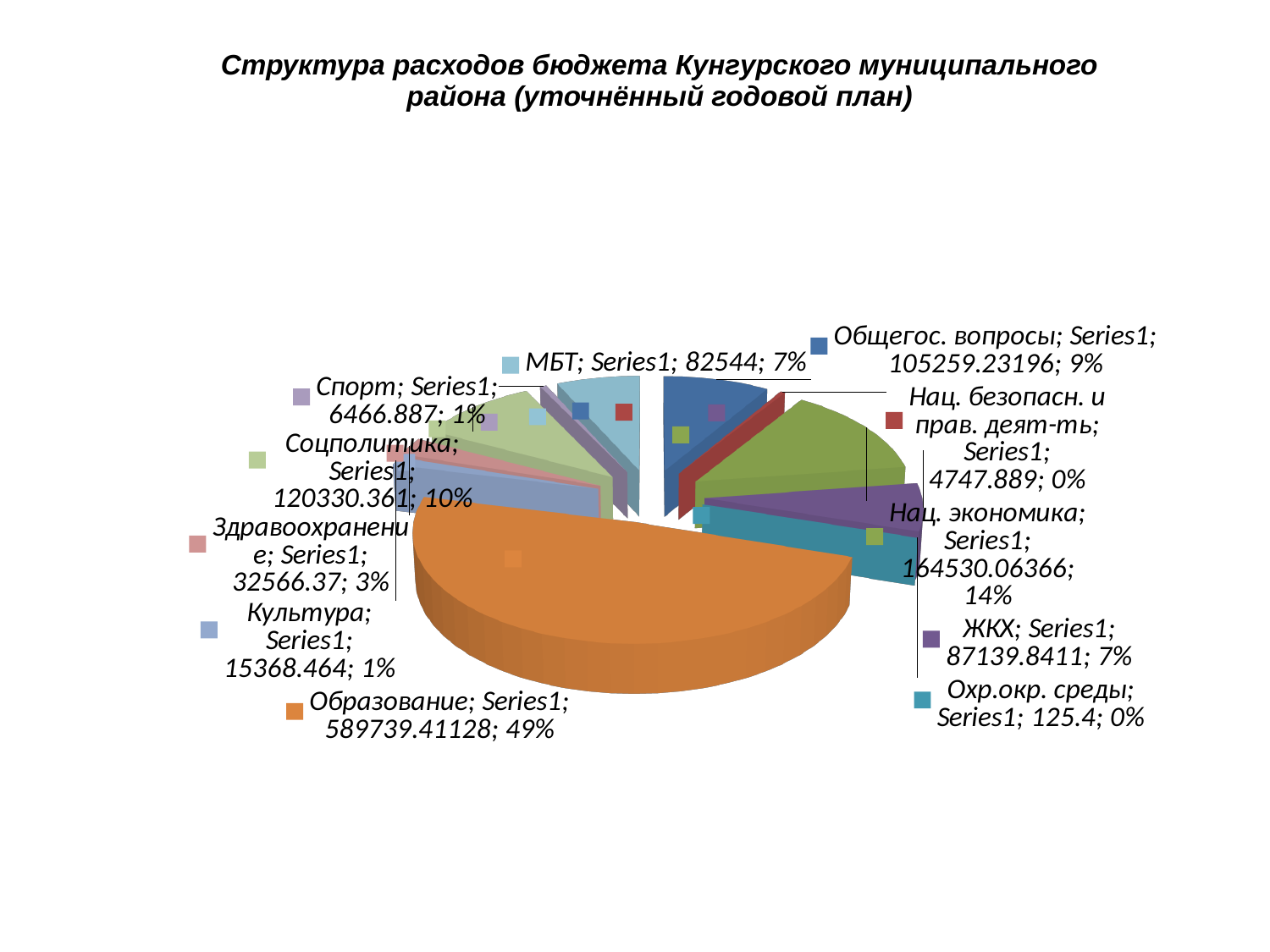
What share of the pie does Образование represent? 49% What share of the pie does Соцполитика represent? 10% What is the value for Нац. экономика? 164530.06366 What kind of chart is shown on the slide? pie chart How many categories are shown in the pie chart? 11 What is the value for Охр.окр. среды? 125.4 What is the title of the chart? Структура расходов бюджета Кунгурского муниципального района (уточнённый годовой план) What is the value for Образование? 589739.41128 Which category has the largest value? Образование What is the value for МБТ? 82544 Which is larger, the value for ЖКХ or the value for Соцполитика? Соцполитика Which category has the smallest value? Охр.окр. среды